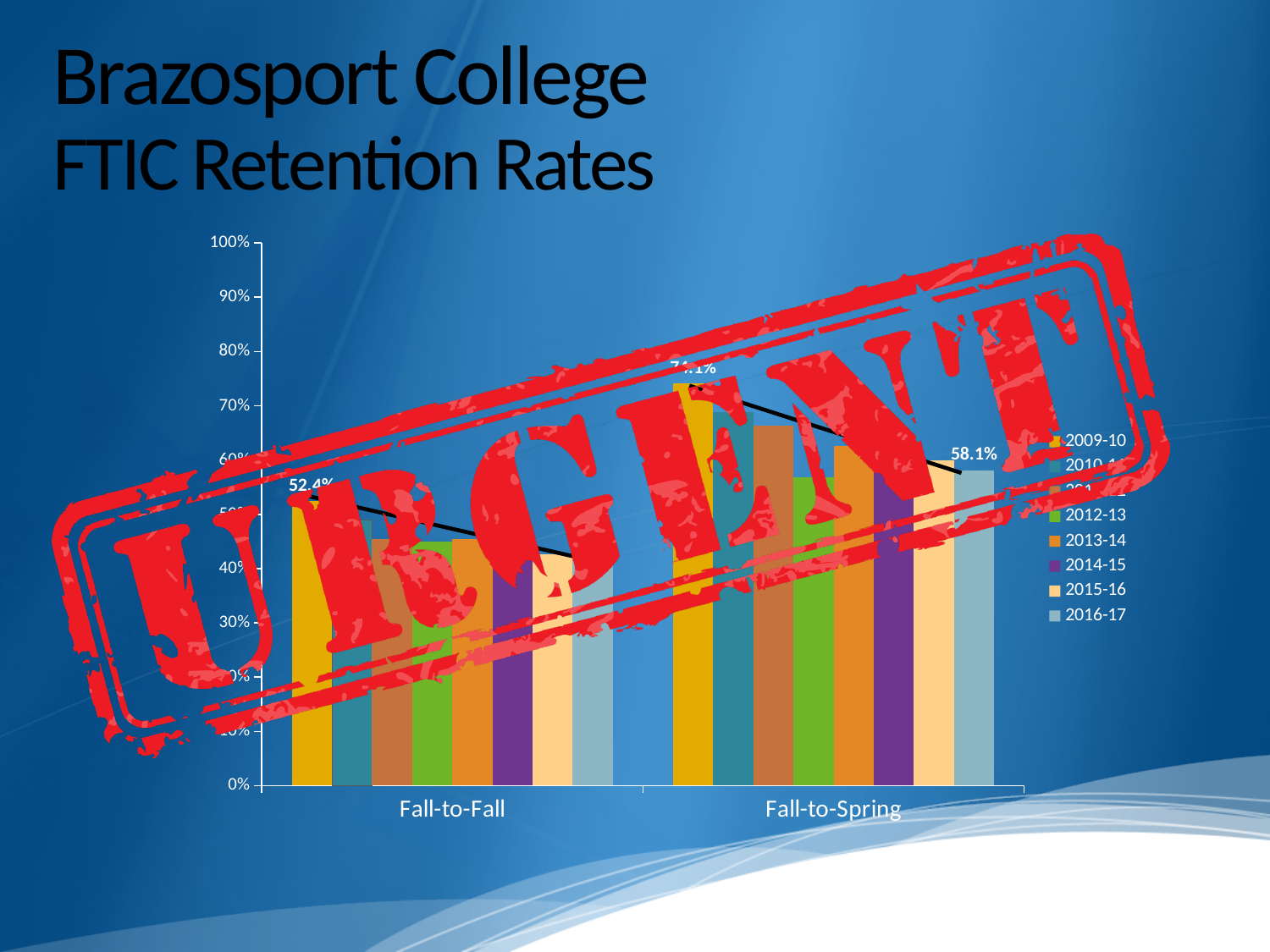
What is the title of the slide containing the chart? Brazosport College FTIC Retention Rates What is the difference between the Fall-to-Spring rate for 2016-17 and the Fall-to-Fall rate for 2009-10? 5.7 percentage points What is the Fall-to-Fall retention rate for 2009-10? 52.4% How many series does the chart's legend list? 8 Is the Fall-to-Spring value for 2009-10 greater or less than 70%? greater What type of chart is shown on the slide? Bar chart What is the Fall-to-Spring retention rate for 2016-17? 58.1% Within the Fall-to-Fall group, which year has the highest retention rate? 2009-10 How many categories are shown on the x axis of the chart? 2 Within the Fall-to-Spring group, do the retention rates generally rise or fall from 2009-10 to 2016-17? Fall Which is larger: the Fall-to-Fall rate for 2009-10 or the Fall-to-Spring rate for 2016-17? Fall-to-Spring 2016-17 Is the Fall-to-Fall value for 2009-10 greater or less than 50%? greater